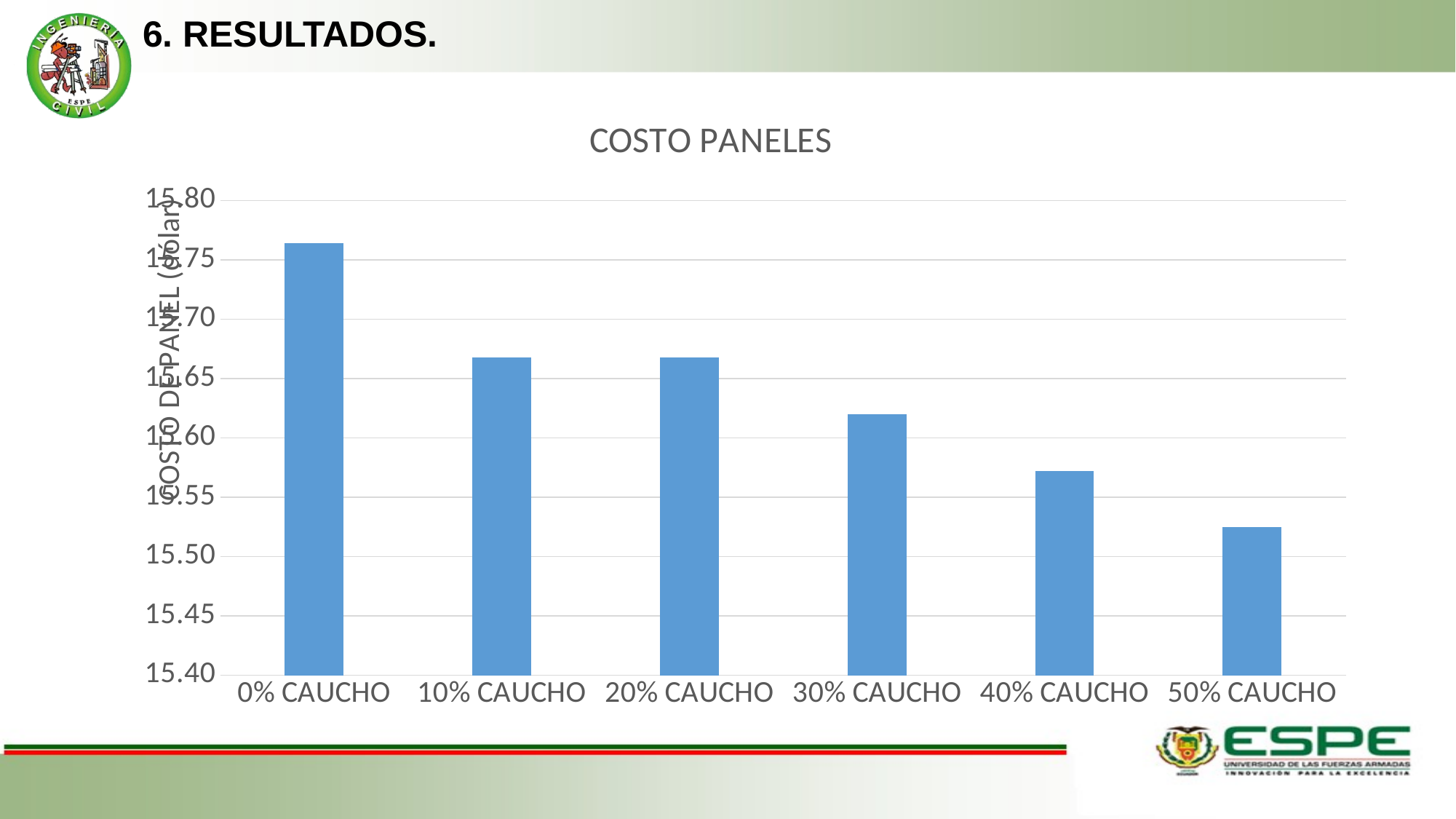
What kind of chart is shown on the slide? bar chart Which category has the highest cost in the chart? 0% CAUCHO Which has a larger value, 0% CAUCHO or 10% CAUCHO? 0% CAUCHO Is the value for 0% CAUCHO greater or less than 15.70? greater Is the value for 50% CAUCHO greater or less than 15.55? less How many categories are shown on the x axis of the chart? 6 Is the value for 10% CAUCHO greater or less than 15.65? greater What is the title of the chart? COSTO PANELES Do the values rise or fall as the rubber percentage increases along the x axis? fall Which category has the lowest cost in the chart? 50% CAUCHO Which has a larger value, 30% CAUCHO or 50% CAUCHO? 30% CAUCHO